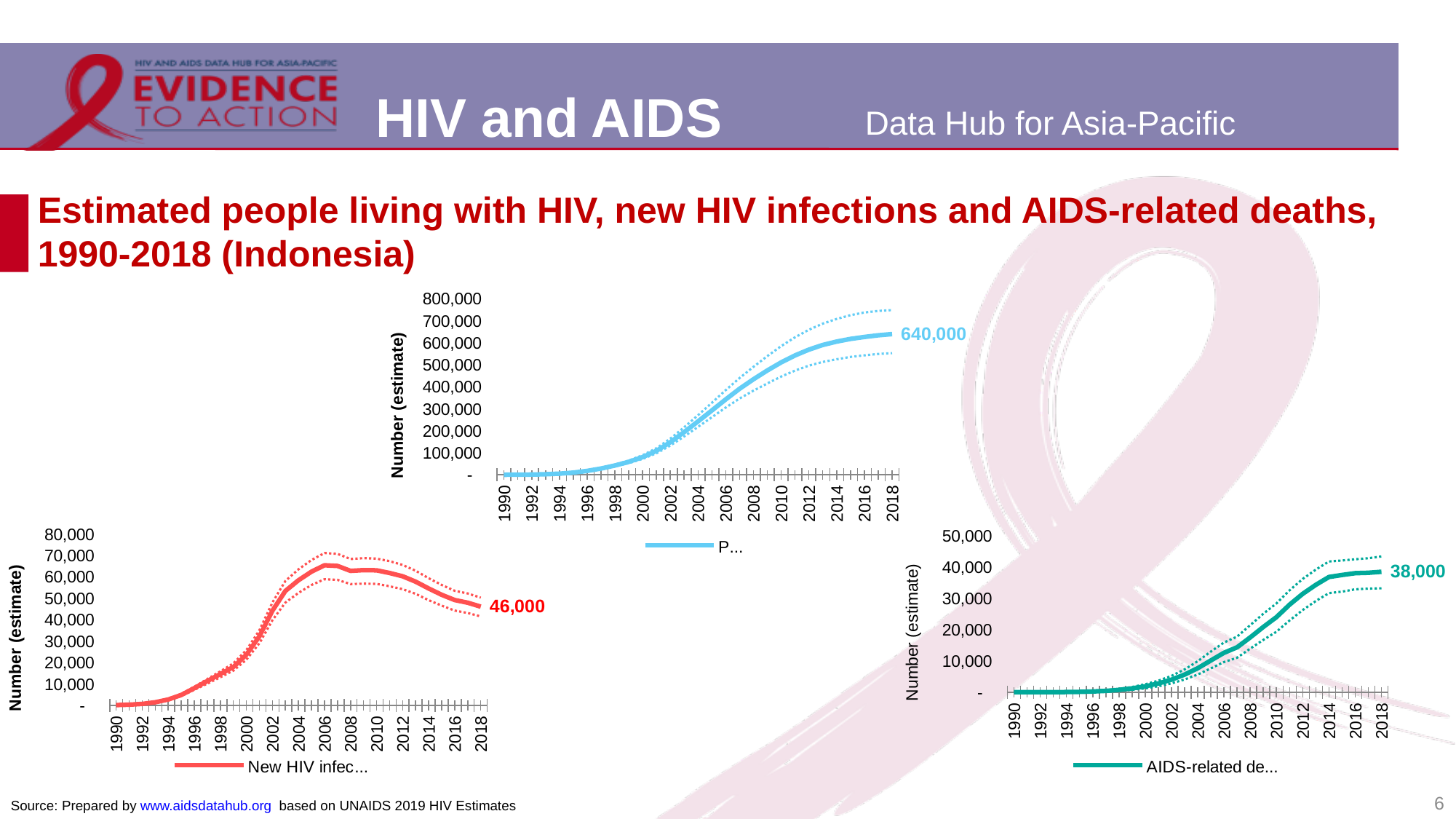
On the top chart, do the values rise or fall from 1990 to 2018? rise On the bottom-right chart, what is the labelled value for 2018? 38,000 On the bottom-right chart, do the values rise or fall from 1990 to 2018? rise How many series does the legend of the bottom-left chart list? 1 On the bottom-left chart, what is the labelled value for 2018? 46,000 What is the difference between the 2018 value on the bottom-left chart (46,000) and the 2018 value on the bottom-right chart (38,000)? 8,000 On the bottom-left chart, is the value for 2006 greater or less than 60,000? greater What is the highest value shown on the vertical axis of the top chart? 800,000 On the top chart, what is the labelled value for 2018? 640,000 Which is larger: the 2018 value on the bottom-left chart or the 2018 value on the bottom-right chart? bottom-left chart (46,000) What kind of chart is the top chart? line chart